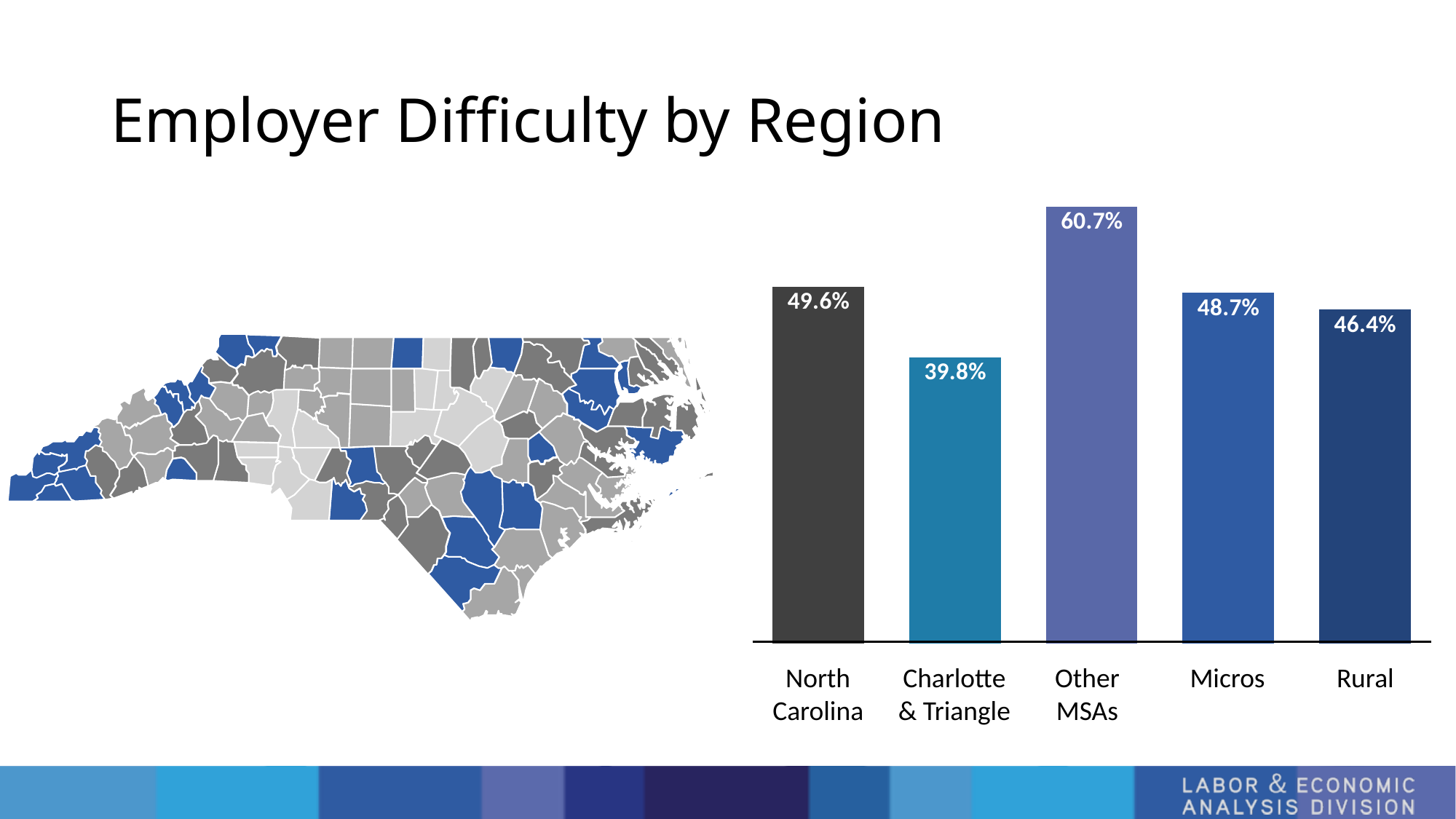
What is the difference between the values for Other MSAs and Charlotte & Triangle? 20.9% What is the difference between the values for North Carolina and Micros? 0.9% Which category has the highest value? Other MSAs What kind of chart is shown on the slide? Bar chart What is the value for Other MSAs? 60.7% What is the value for Rural? 46.4% What is the title of the slide? Employer Difficulty by Region How many categories are shown in the bar chart? 5 What is the value for North Carolina? 49.6% Which is larger, the value for Micros or the value for Rural? Micros What is the value for Charlotte & Triangle? 39.8% Which category has the lowest value? Charlotte & Triangle